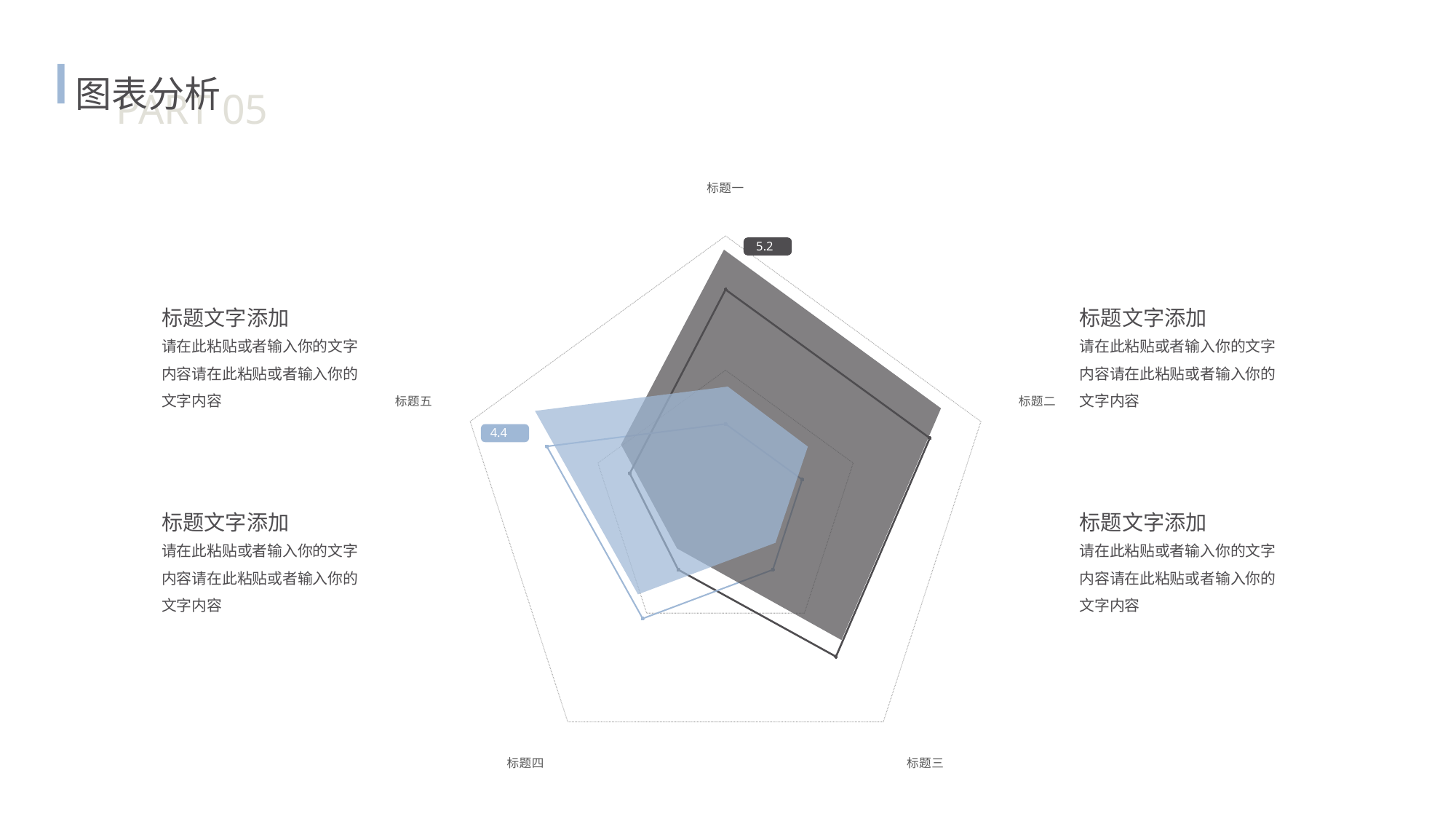
What kind of chart is shown on the slide? radar chart What is the title of the slide containing the radar chart? 图表分析 What value is labelled for the dark grey series at 标题一? 5.2 What value is labelled for the light blue series at 标题五? 4.4 Which is larger: the dark grey series' labelled value at 标题一 or the light blue series' labelled value at 标题五? the dark grey series at 标题一 (5.2) What is the difference between the labelled value 5.2 at 标题一 and the labelled value 4.4 at 标题五? 0.8 Which category label appears at the top of the radar chart? 标题一 How many categories (axes) does the radar chart have? 5